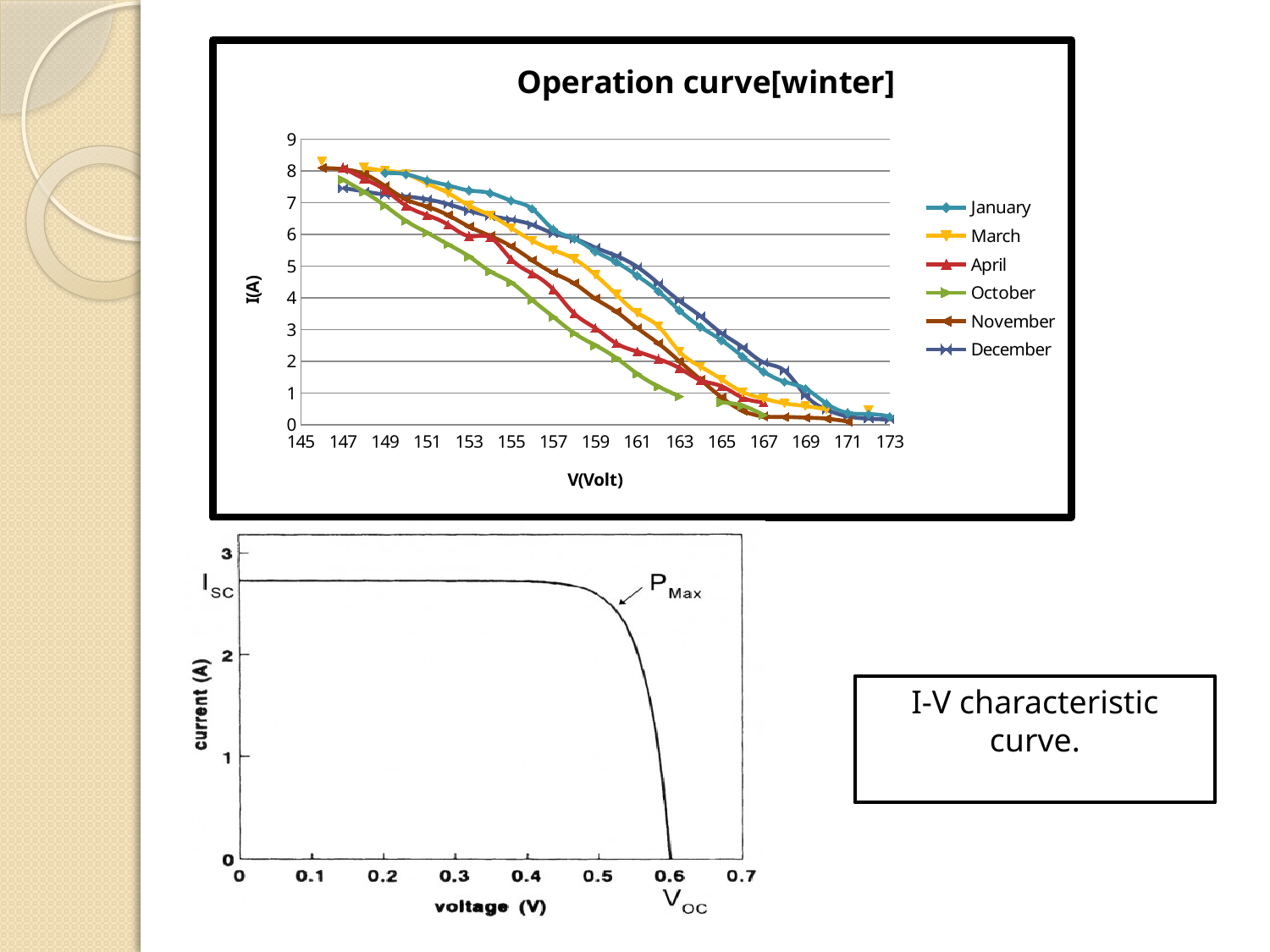
In the 'Operation curve[winter]' chart, is the value for October at 155 V greater or less than 5? less In the 'Operation curve[winter]' chart, which series is shown in green? October In the I-V characteristic curve chart at the bottom of the slide, at what voltage does the curve reach 0 current (V_OC)? 0.6 In the 'Operation curve[winter]' chart, which series has the lowest value at 155 V? October In the 'Operation curve[winter]' chart, is the value for April at 161 V greater or less than 3? less In the 'Operation curve[winter]' chart, is the value for January at 155 V greater or less than 6? greater In the 'Operation curve[winter]' chart, do the current values rise or fall as voltage increases along the x axis? fall In the 'Operation curve[winter]' chart, which series has the larger value at 159 V, January or October? January In the 'Operation curve[winter]' chart, what is the label of the y axis? I(A) What kind of chart is the 'Operation curve[winter]' chart? line chart In the I-V characteristic curve chart at the bottom of the slide, does the current rise or fall as voltage increases along the x axis? fall In the 'Operation curve[winter]' chart, how many series does the legend list? 6